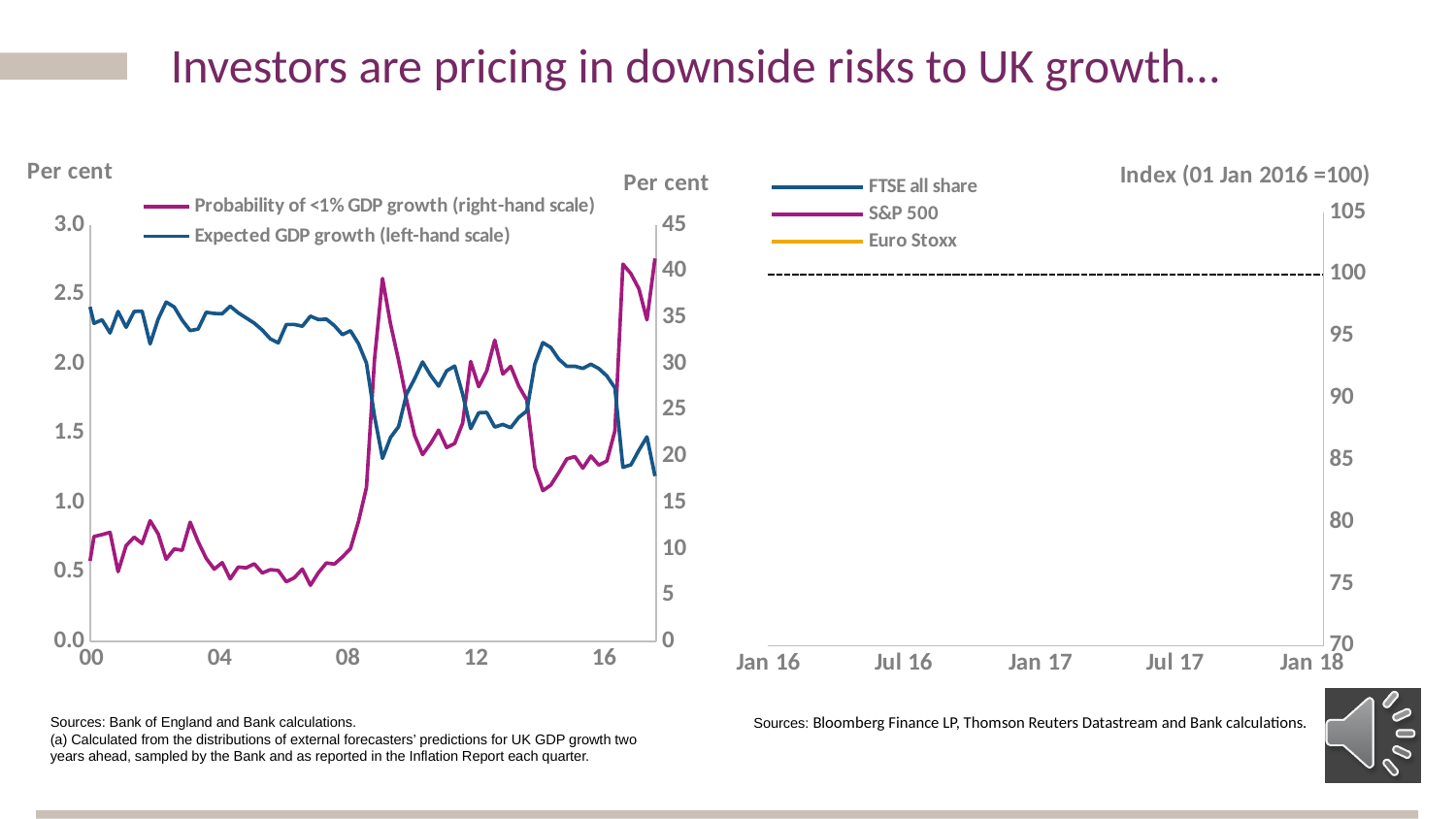
On the right chart, what is the highest value shown on the vertical axis? 105 On the right chart, what is the index base stated in the axis title? 01 Jan 2016 = 100 On the left chart, which series is plotted against the right-hand scale? Probability of <1% GDP growth On the left chart, does the Expected GDP growth line rise or fall overall from 2000 to the end of the series? fall On the left chart, is the Probability of <1% GDP growth at the end of the series greater or less than 30 per cent? greater On the left chart, does the Probability of <1% GDP growth line rise or fall overall from 2000 to the end of the series? rise On the left chart, what kind of chart is used to show expected GDP growth and the probability of <1% GDP growth? line chart On the left chart, how many series does the legend list? 2 On the left chart, is the Expected GDP growth at the end of the series greater or less than 1.5 per cent? less On the left chart, is the Probability of <1% GDP growth in 2000 greater or less than 15 per cent? less On the right chart, how many series does the legend list? 3